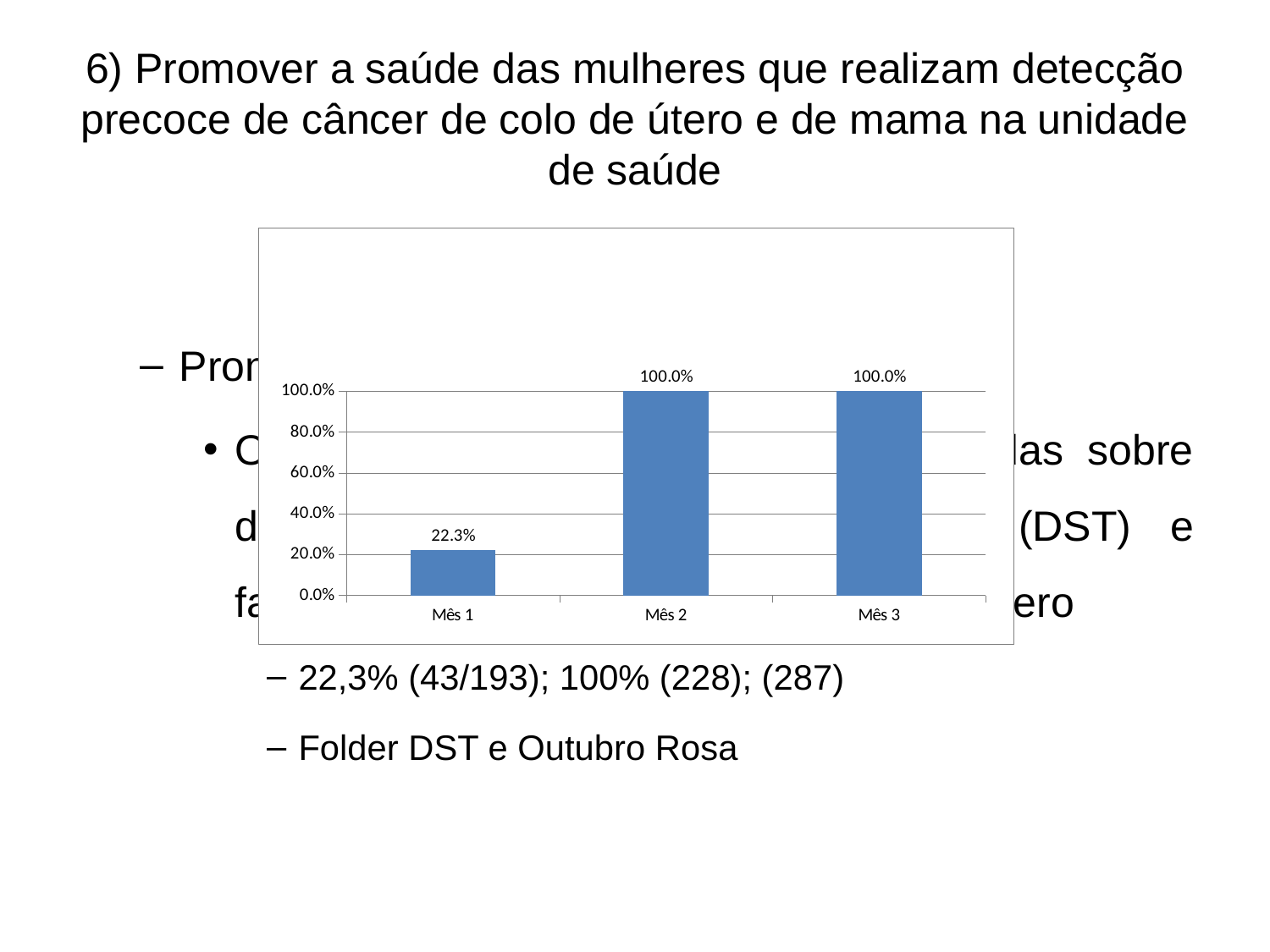
What is the value for Mês 3? 100.0% Do the values rise or fall from Mês 1 to Mês 2? rise Is the value for Mês 1 greater or less than 40.0%? less What is the value for Mês 2? 100.0% Which category has the lowest value? Mês 1 Which is larger, the value for Mês 1 or the value for Mês 3? Mês 3 What colour are the bars in the chart? blue What is the difference between the values for Mês 2 and Mês 1? 77.7% What kind of chart is shown on the slide? bar chart What is the value for Mês 1? 22.3% What is the highest tick value shown on the y axis? 100.0% How many categories are shown on the x axis? 3